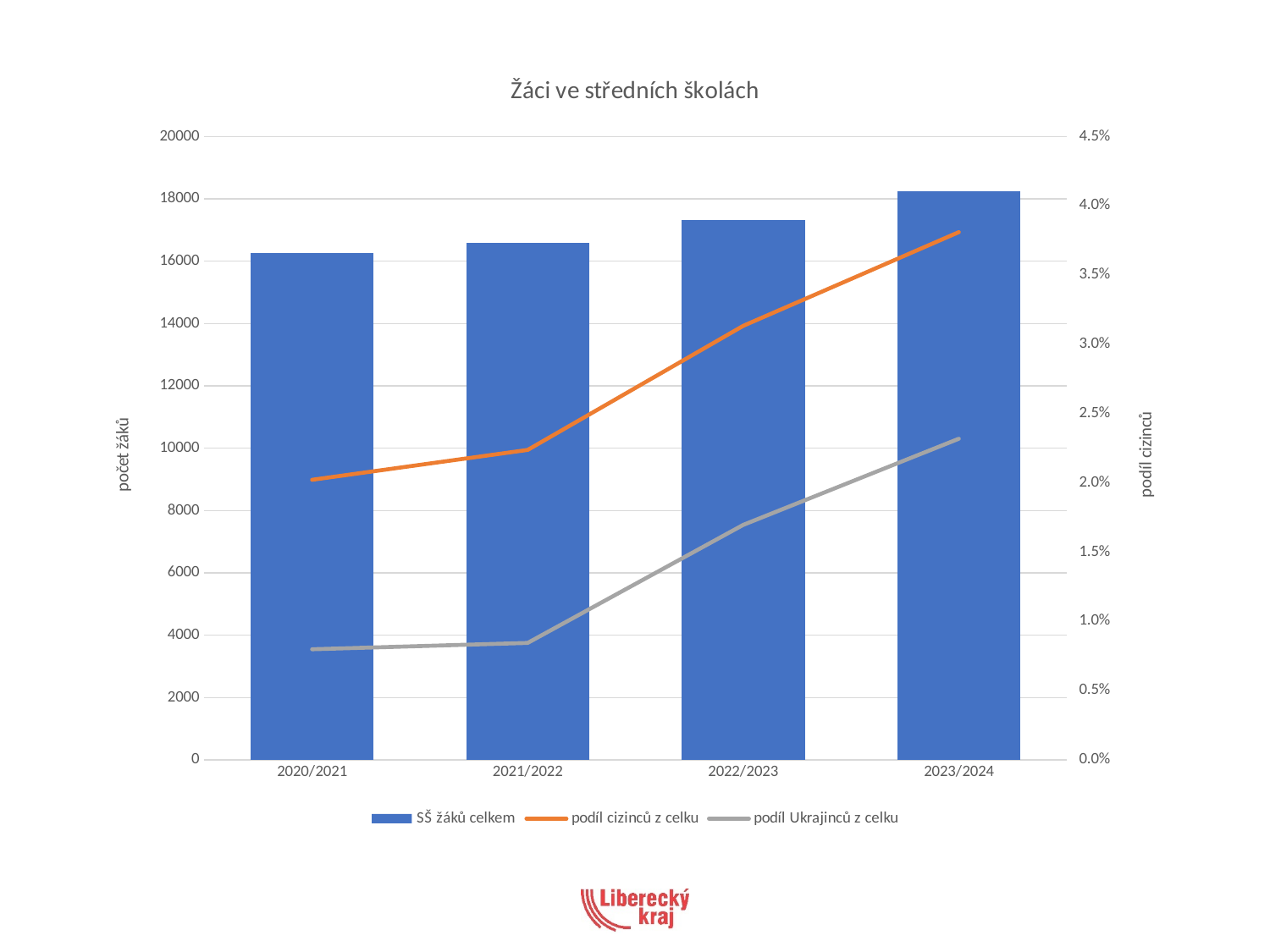
What colour is the line for podíl Ukrajinců z celku? grey Is the value for podíl Ukrajinců z celku in 2020/2021 greater or less than 1.0%? less In 2022/2023, which is larger: podíl cizinců z celku or podíl Ukrajinců z celku? podíl cizinců z celku Is the value for SŠ žáků celkem in 2020/2021 greater or less than 18000? less Does the podíl cizinců z celku line rise or fall from 2020/2021 to 2023/2024? rise How many series does the legend list? 3 Is the value for podíl cizinců z celku in 2023/2024 greater or less than 3.5%? greater What is the title of the chart? Žáci ve středních školách Which school year has the highest value for SŠ žáků celkem? 2023/2024 How many school years are shown on the x axis? 4 Which school year has the lowest value for SŠ žáků celkem? 2020/2021